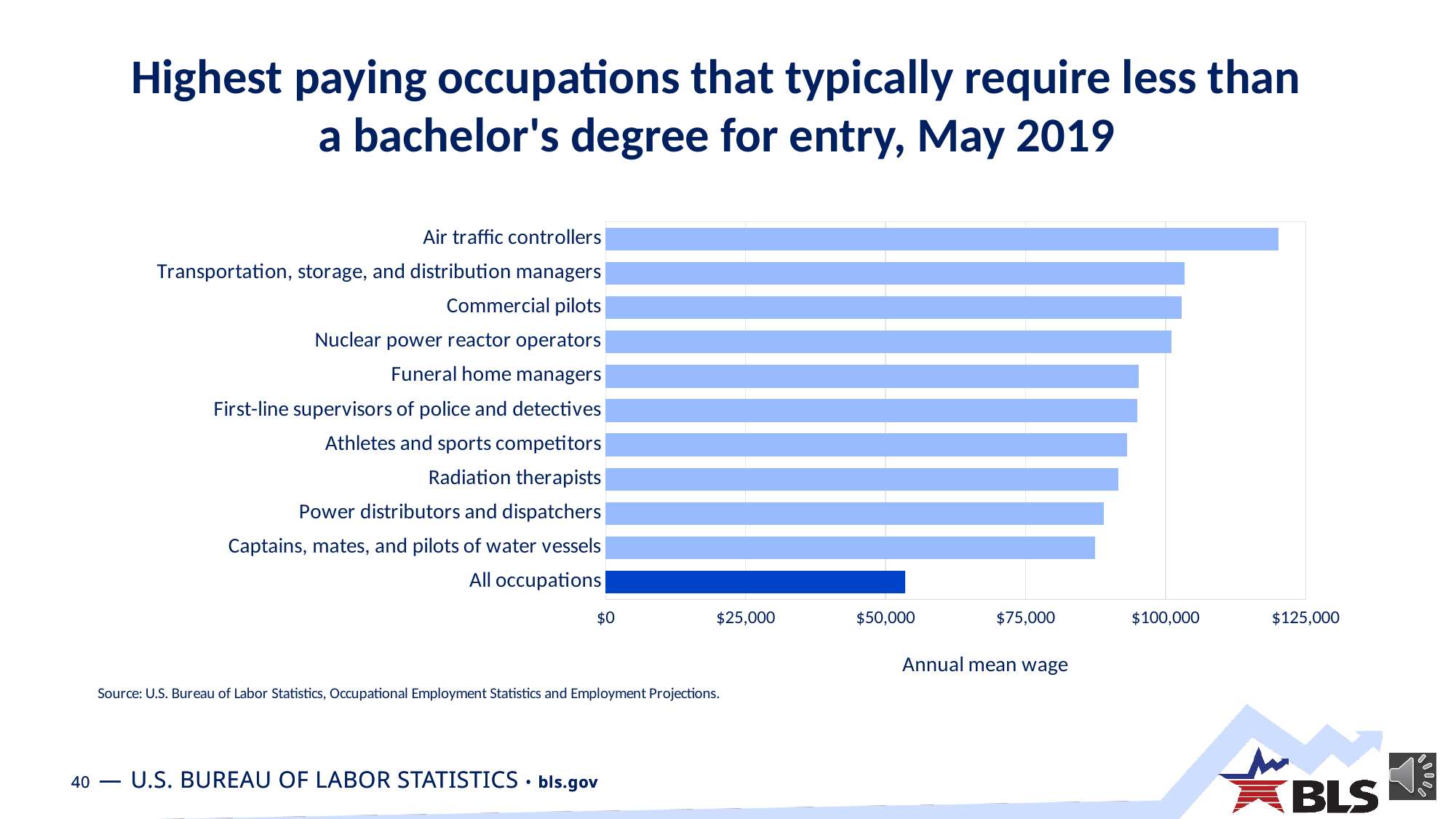
Is the annual mean wage for Air traffic controllers greater or less than $100,000? greater How many bars are plotted in the chart? 11 Is the annual mean wage for All occupations greater or less than $75,000? less Which occupation has the highest annual mean wage in the chart? Air traffic controllers Which has a higher annual mean wage, Athletes and sports competitors or Captains, mates, and pilots of water vessels? Athletes and sports competitors Which bar is shown in a darker blue than the others? All occupations Which category has the lowest annual mean wage in the chart? All occupations What kind of chart is shown on the slide? Bar chart Is the annual mean wage for Captains, mates, and pilots of water vessels greater or less than $75,000? greater What is the title of the horizontal axis? Annual mean wage Which has a higher annual mean wage, Air traffic controllers or Commercial pilots? Air traffic controllers